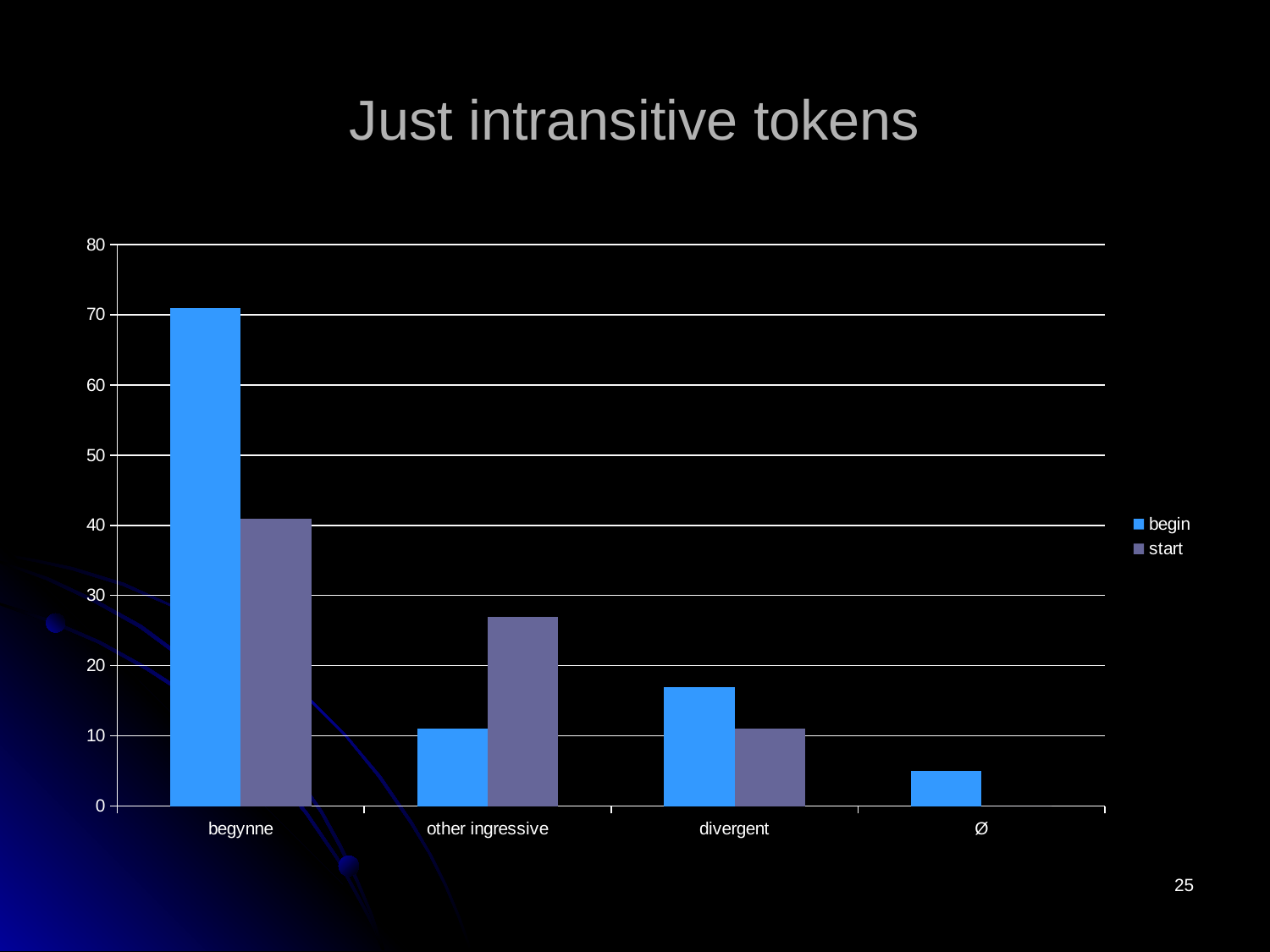
What is the title of the chart? Just intransitive tokens What kind of chart is shown on the slide? bar chart Which category has the highest value for the begin series? begynne How many categories are shown on the x axis? 4 Which category has the lowest value for the begin series? Ø How many series does the legend list? 2 Is the value for begin in the begynne category greater or less than 70? greater Is the value for start in the begynne category greater or less than 40? greater Which category has the highest value for the start series? begynne In the other ingressive category, which series has the larger value, begin or start? start Is the value for begin in the Ø category greater or less than 10? less In the divergent category, which series has the larger value, begin or start? begin